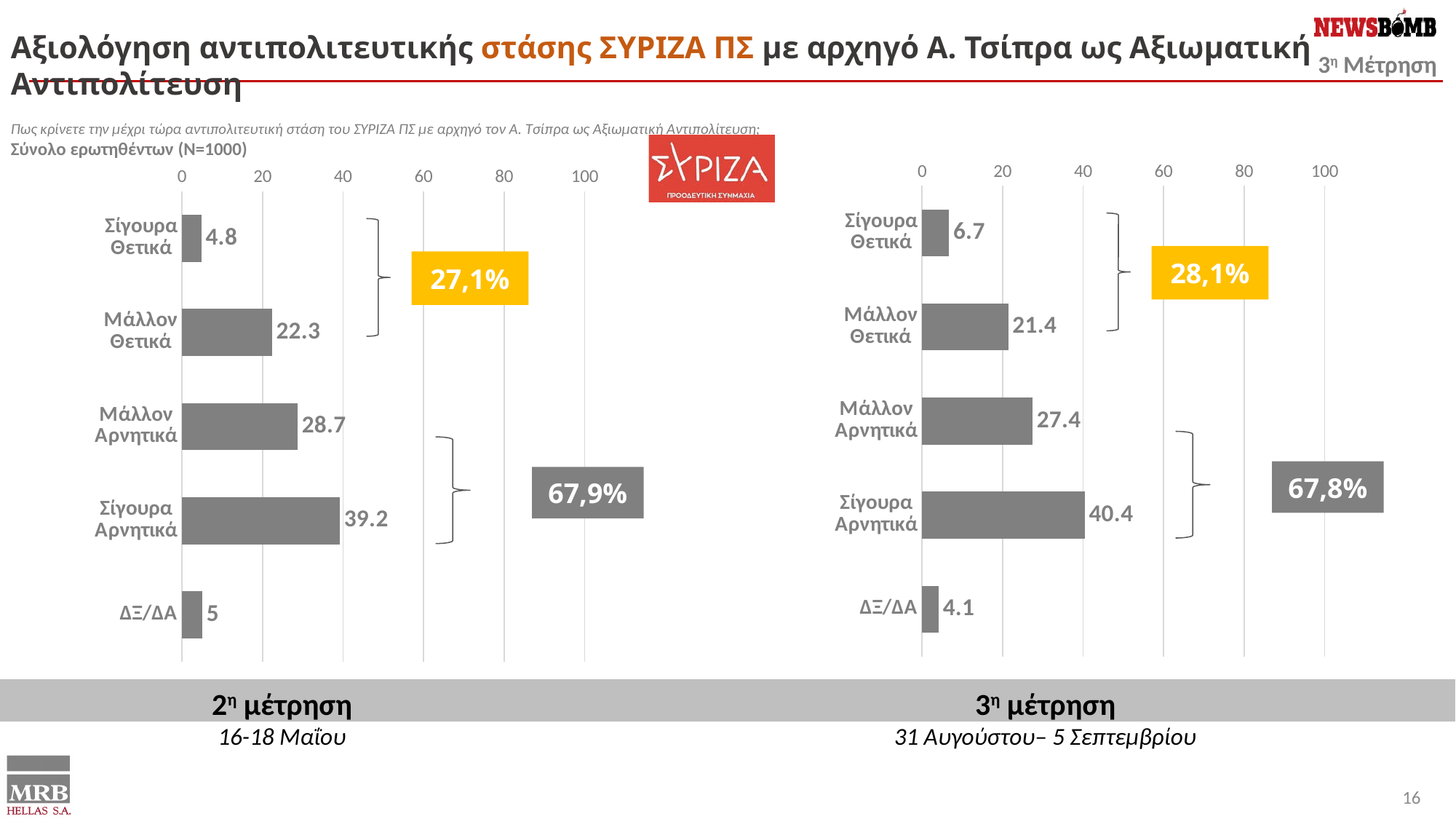
How many categories are shown in the right chart (3η μέτρηση)? 5 What type of chart is used on this slide? Bar chart In the right chart (3η μέτρηση), what is the difference between Σίγουρα Αρνητικά and Σίγουρα Θετικά? 33.7 In the left chart (2η μέτρηση), is the value for Μάλλον Αρνητικά greater or less than 20? greater In the right chart (3η μέτρηση), what is the value for Μάλλον Θετικά? 21.4 Which is larger: Σίγουρα Θετικά in the left chart (2η μέτρηση) or Σίγουρα Θετικά in the right chart (3η μέτρηση)? 3η μέτρηση (6.7) In the right chart (3η μέτρηση), which category has the lowest value? ΔΞ/ΔΑ In the right chart (3η μέτρηση), what combined percentage is shown in the yellow box for the positive categories? 28,1% In the left chart (2η μέτρηση), which category has the highest value? Σίγουρα Αρνητικά In the left chart (2η μέτρηση), what is the difference between Σίγουρα Αρνητικά and Μάλλον Αρνητικά? 10.5 In the right chart (3η μέτρηση), what is the value for ΔΞ/ΔΑ? 4.1 In the left chart (2η μέτρηση), what is the value for Σίγουρα Αρνητικά? 39.2